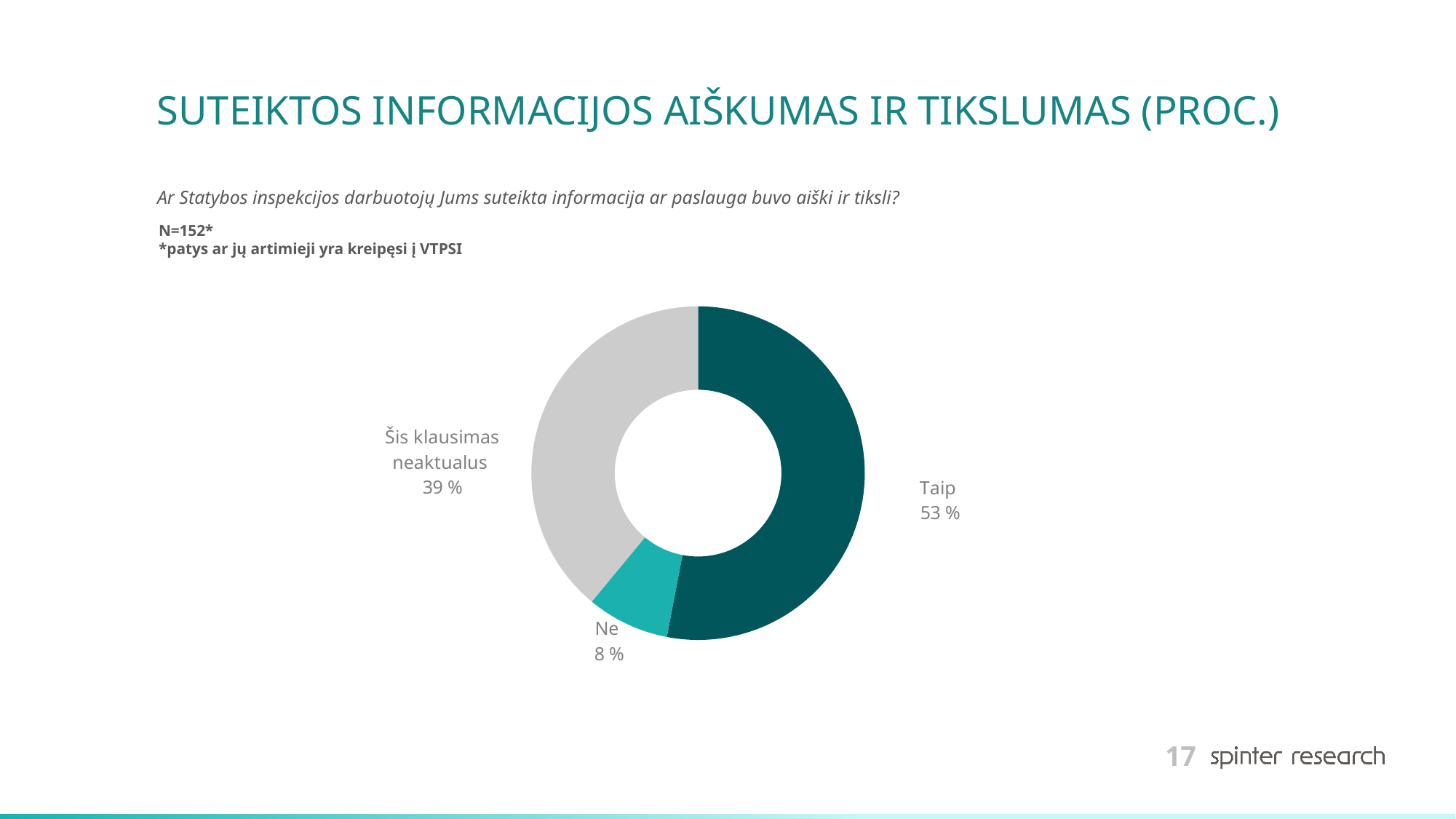
What kind of chart is shown on the slide? Pie chart (doughnut) What is the difference in percentage points between "Taip" and "Šis klausimas neaktualus"? 14 How many categories are shown in the chart? 3 Which is larger, the share for "Taip" or the share for "Šis klausimas neaktualus"? Taip What is the difference in percentage points between "Šis klausimas neaktualus" and "Ne"? 31 What percentage of respondents answered "Šis klausimas neaktualus"? 39 % Which category has the smallest share of the chart? Ne What is the sample size (N) stated on the slide? 152 What percentage of respondents answered "Ne"? 8 % Which category has the largest share of the chart? Taip What percentage of respondents answered "Taip"? 53 % What colour is the "Ne" slice of the chart? Light teal